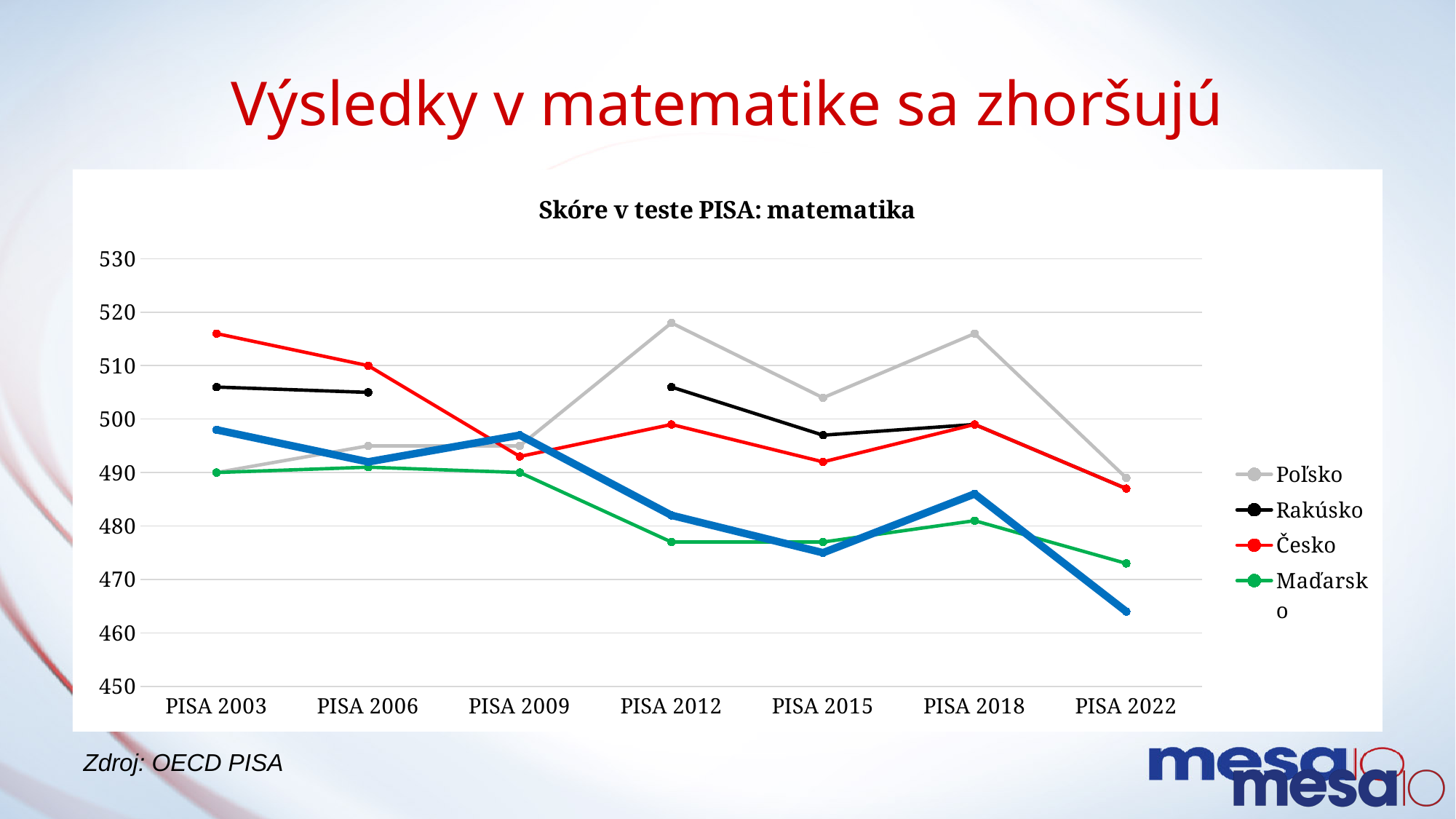
What is the title of the chart? Skóre v teste PISA: matematika Is the value for Poľsko at PISA 2012 greater or less than 510? greater How many series does the chart legend list? 4 Which series has the highest value at PISA 2012? Poľsko Is the value for Maďarsko at PISA 2012 greater or less than 480? less What kind of chart is shown on the slide? line chart Is the value for Rakúsko at PISA 2015 greater or less than 500? less How many PISA rounds are shown on the x axis? 7 Does the value for Česko rise or fall from PISA 2003 to PISA 2009? fall At PISA 2018, which is higher: Poľsko or Česko? Poľsko Which series has the lowest value at PISA 2018? Maďarsko